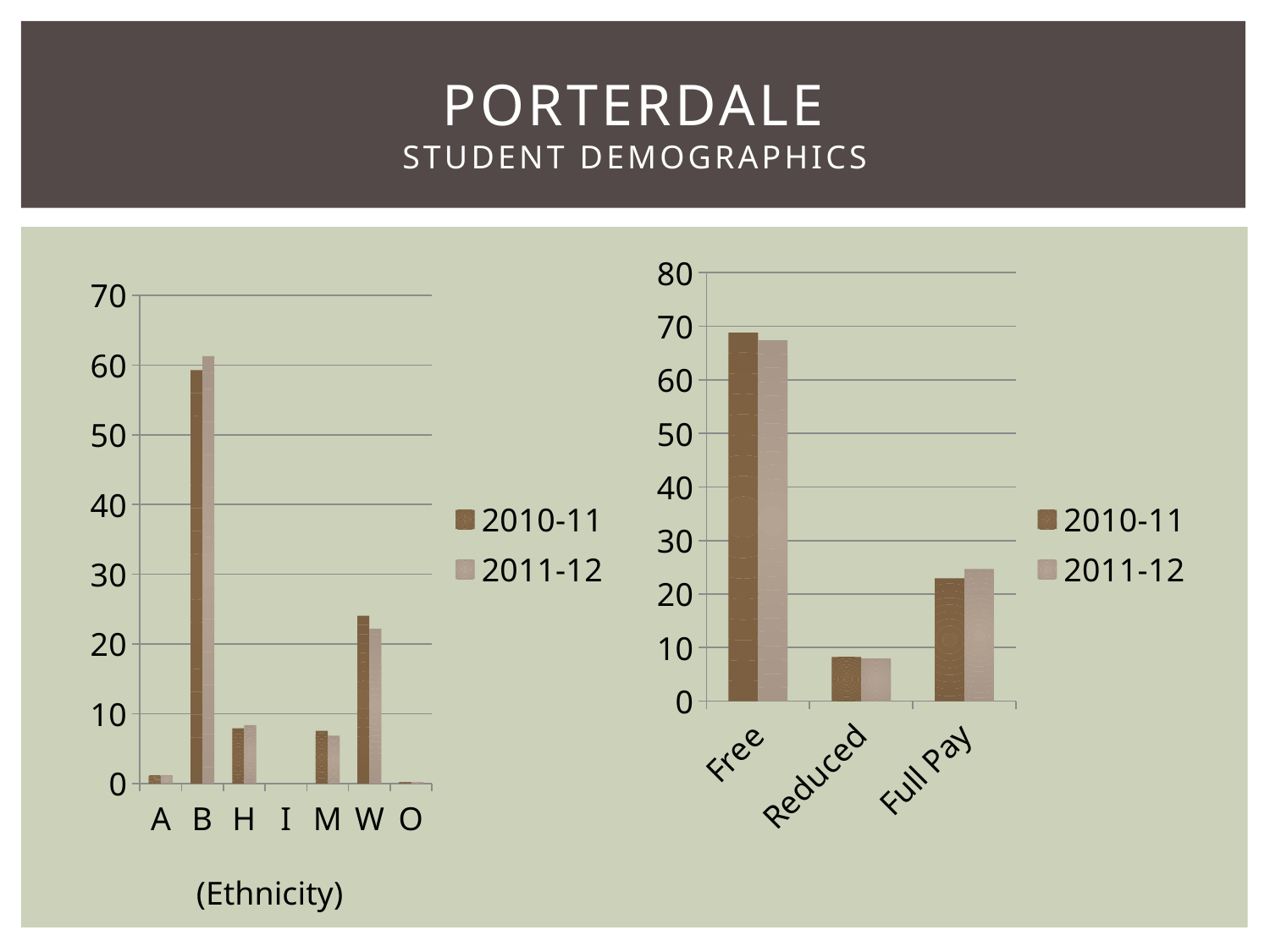
On the left (Ethnicity) chart, is the 2010-11 value for B greater or less than 50? greater On the left (Ethnicity) chart, which category has the highest values? B How many series does the legend of the left (Ethnicity) chart list? 2 On the right chart, which category has the lowest values? Reduced How many ethnicity categories are shown on the left chart? 7 On the right chart, which category has the highest values? Free On the right chart, how many categories are shown on the x axis? 3 On the right chart, is the 2010-11 value for Free greater or less than 60? greater On the left (Ethnicity) chart, is the 2011-12 value for H greater or less than 10? less What kind of chart is the Ethnicity chart on the left of the slide? bar chart